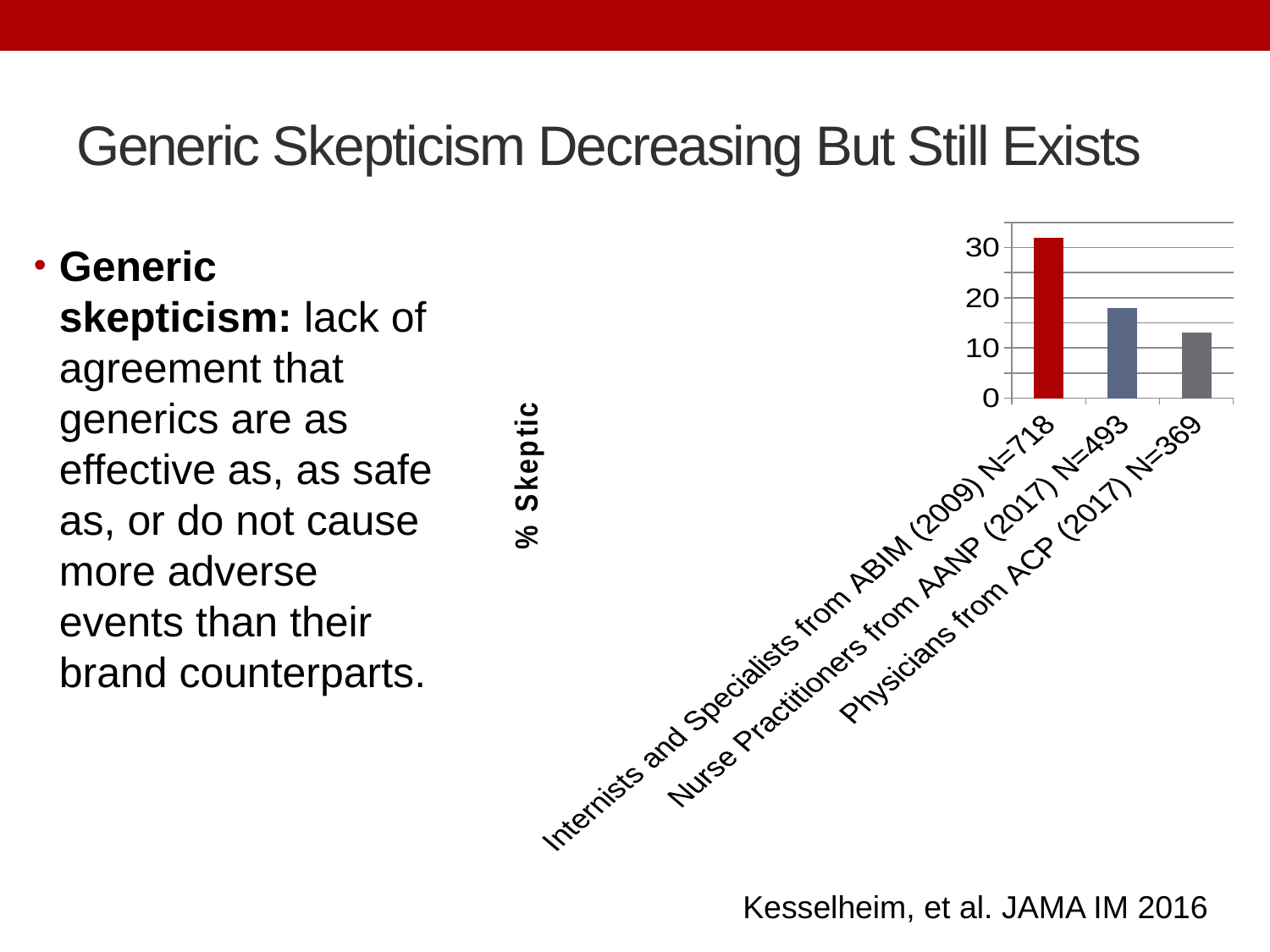
What colour is the bar for Internists and Specialists from ABIM (2009) N=718? red How many categories are plotted on the chart? 3 Do the bar values rise or fall from left to right across the categories? fall Is the value for Internists and Specialists from ABIM (2009) N=718 greater or less than 30? greater Is the value for Nurse Practitioners from AANP (2017) N=493 greater or less than 20? less Which category has the lowest % Skeptic value? Physicians from ACP (2017) N=369 Which category has the highest % Skeptic value? Internists and Specialists from ABIM (2009) N=718 Which is larger: the value for Nurse Practitioners from AANP (2017) N=493 or the value for Physicians from ACP (2017) N=369? Nurse Practitioners from AANP (2017) N=493 Is the value for Physicians from ACP (2017) N=369 greater or less than 10? greater What kind of chart is shown on the slide? bar chart What is the label on the vertical axis of the chart? % Skeptic